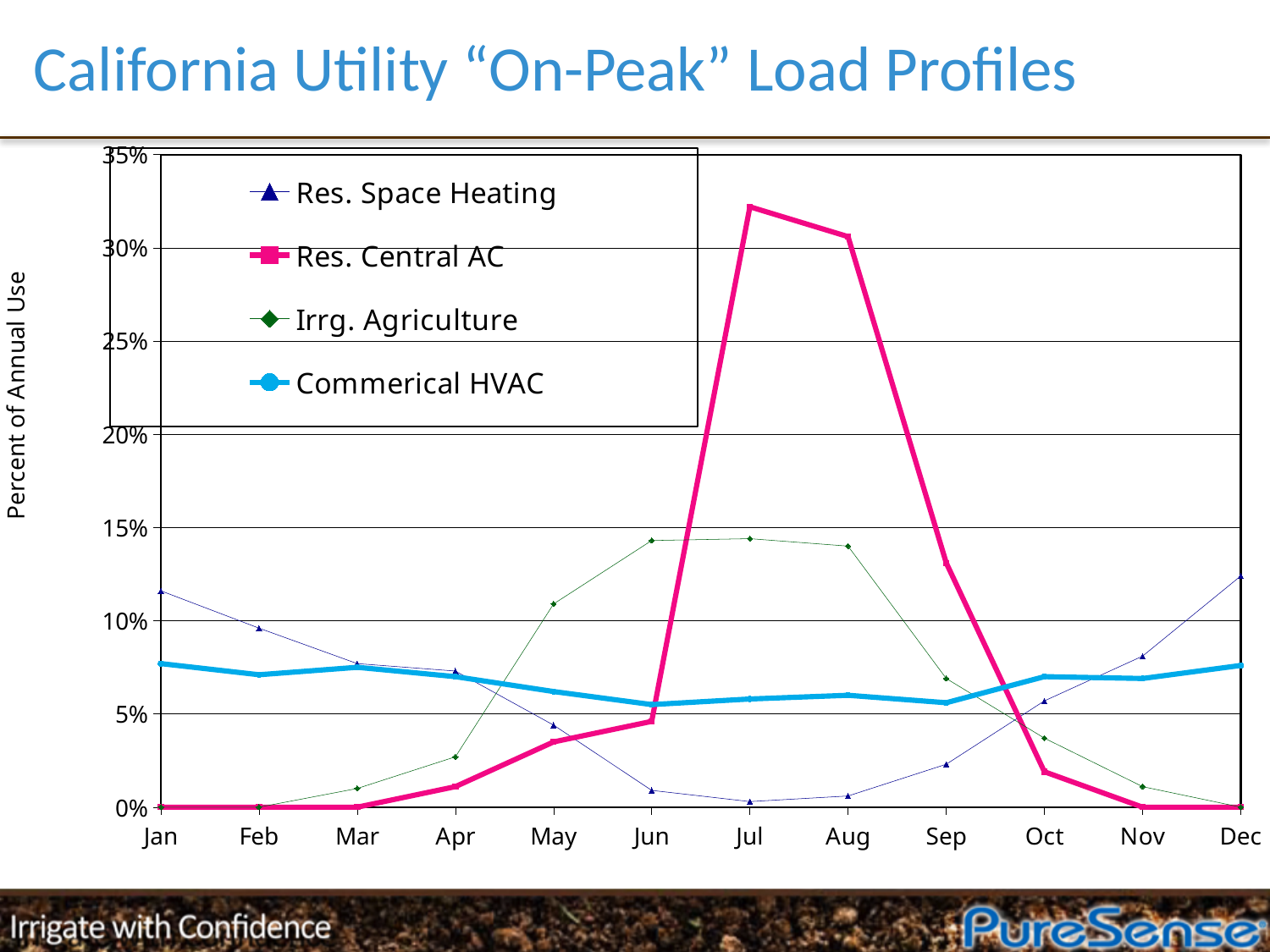
What kind of chart is shown on the slide? line chart In Oct, which is larger: Commerical HVAC or Res. Central AC? Commerical HVAC In Jan, which is larger: Res. Space Heating or Commerical HVAC? Res. Space Heating Is the value for Irrg. Agriculture in Jun greater or less than 10%? greater Is the value for Res. Central AC in Jul greater or less than 30%? greater In which month does Res. Central AC reach its highest value? Jul How many series does the legend list? 4 Is the value for Commerical HVAC in Jan greater or less than 5%? greater How many months are plotted along the x axis? 12 Does the Res. Space Heating line rise or fall from Jan to Jul? fall Which series reaches the highest value anywhere on the chart? Res. Central AC